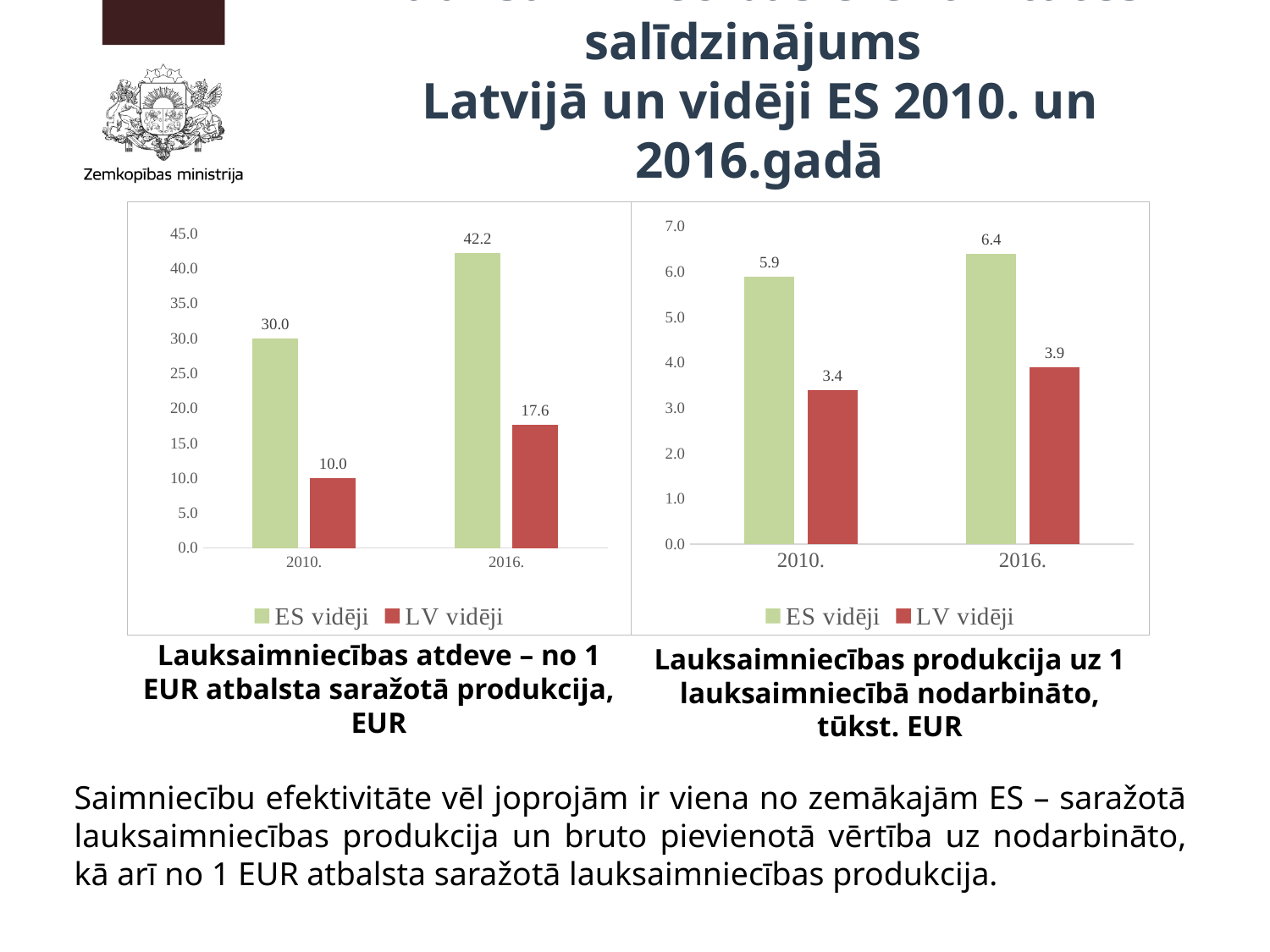
How many series does the legend of the left chart (Lauksaimniecības atdeve) list? 2 What kind of chart is the right chart (Lauksaimniecības produkcija uz 1 nodarbināto)? bar chart In the right chart (Lauksaimniecības produkcija uz 1 nodarbināto), what is the value for ES vidēji in 2010.? 5.9 In the right chart (Lauksaimniecības produkcija uz 1 nodarbināto), does the LV vidēji value rise or fall from 2010. to 2016.? rise In the right chart (Lauksaimniecības produkcija uz 1 nodarbināto), what is the difference between ES vidēji and LV vidēji in 2010.? 2.5 In the left chart (Lauksaimniecības atdeve), which is larger: LV vidēji in 2010. or LV vidēji in 2016.? LV vidēji in 2016. In the left chart (Lauksaimniecības atdeve), what is the value for ES vidēji in 2016.? 42.2 In the left chart (Lauksaimniecības atdeve), what is the value for LV vidēji in 2010.? 10.0 In the right chart (Lauksaimniecības produkcija uz 1 nodarbināto), what is the value for LV vidēji in 2016.? 3.9 In the left chart (Lauksaimniecības atdeve), which bar is the highest? ES vidēji in 2016. In the left chart (Lauksaimniecības atdeve), what is the difference between ES vidēji and LV vidēji in 2016.? 24.6 In the right chart (Lauksaimniecības produkcija uz 1 nodarbināto), which bar is the lowest? LV vidēji in 2010.